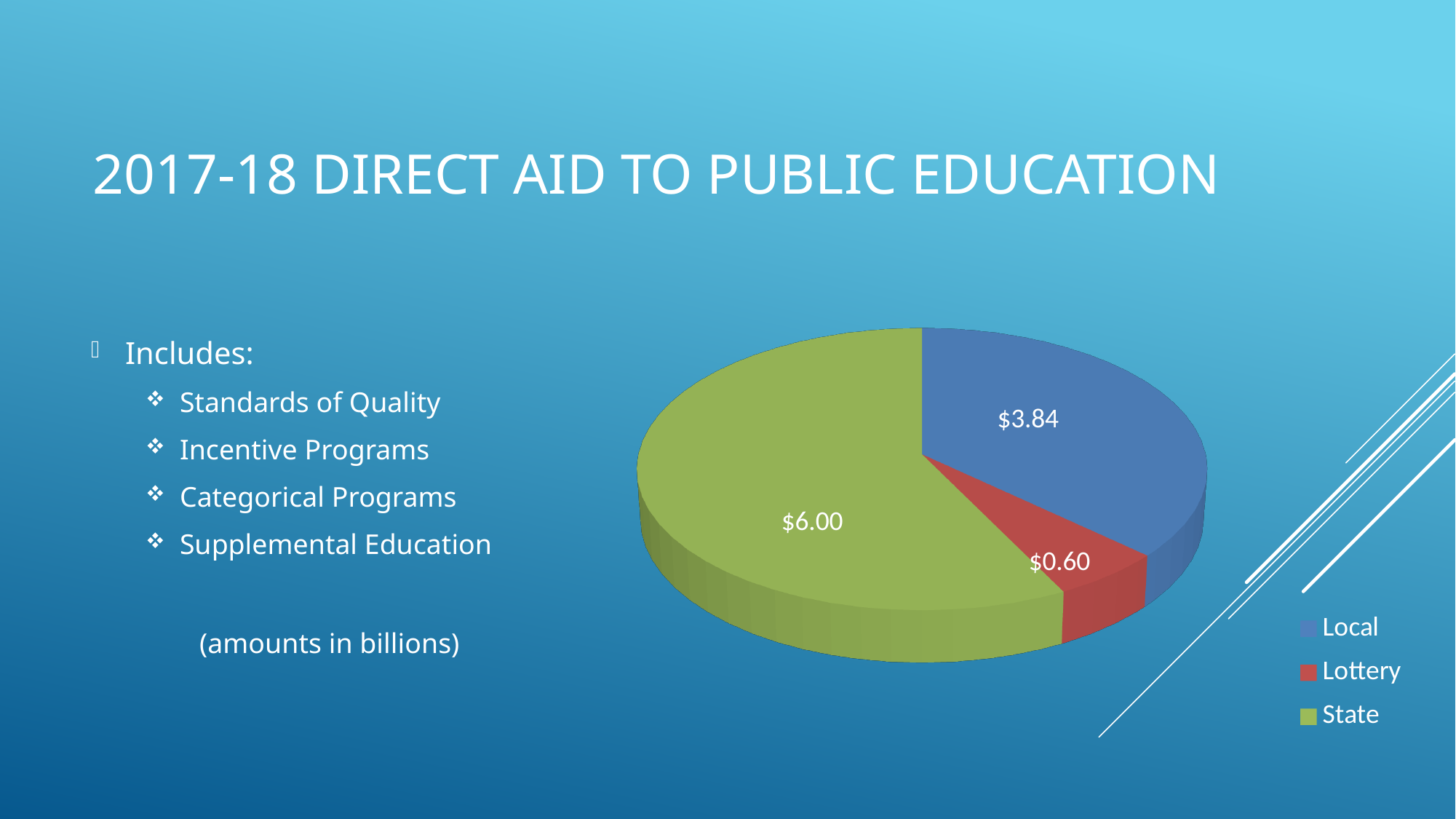
Which category has the smallest slice in the pie chart? Lottery What is the difference between the State and Local values in the pie chart? $2.16 What is the value of the Lottery slice in the pie chart? $0.60 What type of chart is shown on the slide? Pie chart What is the total of all slices in the pie chart? $10.44 What is the difference between the Local and Lottery values in the pie chart? $3.24 What is the value of the State slice in the pie chart? $6.00 Which is larger in the pie chart, Local or Lottery? Local Which colour represents Lottery in the pie chart legend? Red What is the value of the Local slice in the pie chart? $3.84 How many slices does the pie chart have? 3 Which category has the largest slice in the pie chart? State